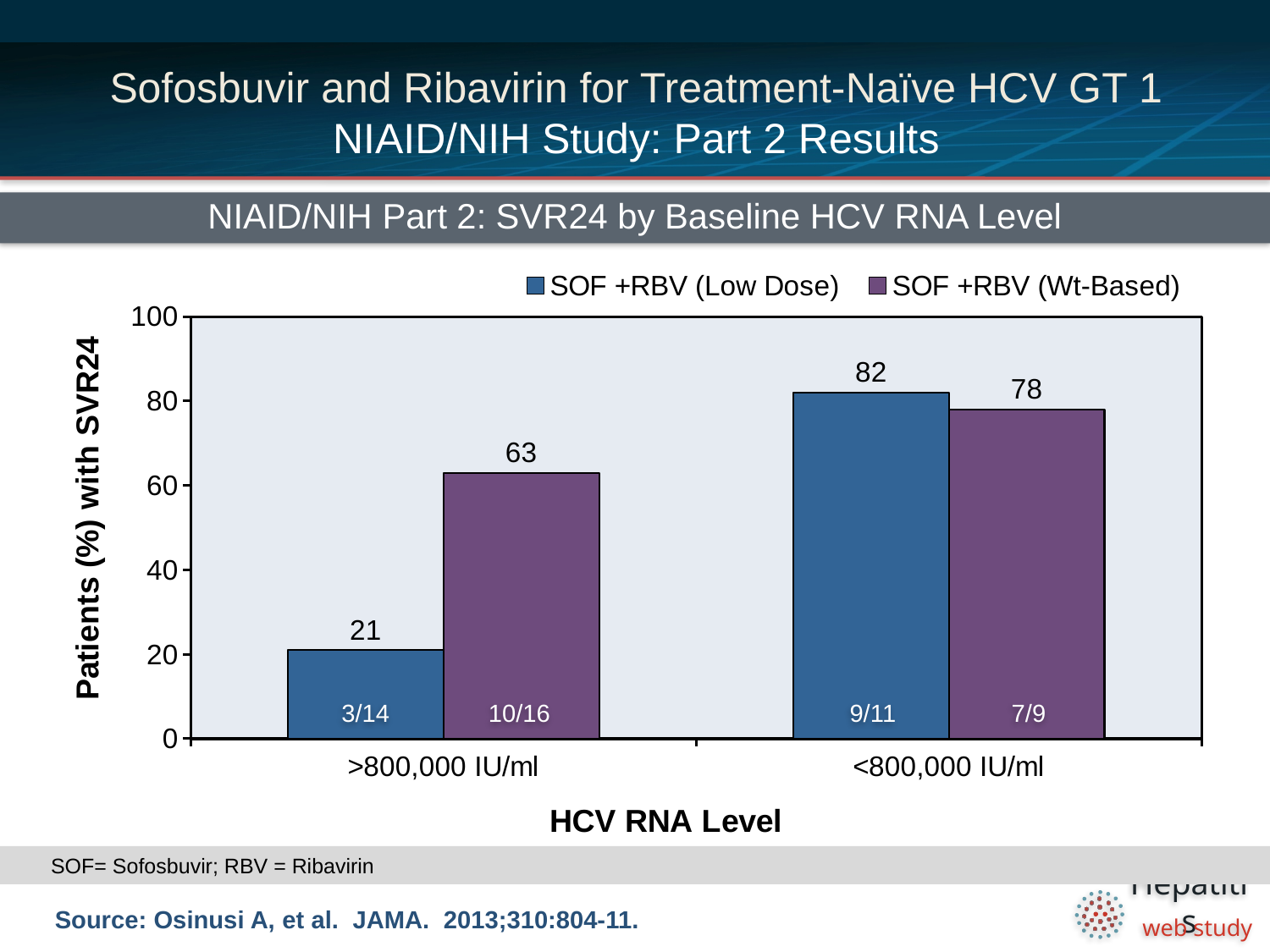
What is the SVR24 rate for SOF +RBV (Low Dose) in the >800,000 IU/ml group? 21 What is the SVR24 rate for SOF +RBV (Low Dose) in the <800,000 IU/ml group? 82 What is the SVR24 rate for SOF +RBV (Wt-Based) in the <800,000 IU/ml group? 78 How many series does the legend list? 2 What is the difference in SVR24 rate between SOF +RBV (Wt-Based) and SOF +RBV (Low Dose) in the >800,000 IU/ml group? 42 How many HCV RNA level categories are shown on the x axis? 2 What fraction of patients is shown inside the SOF +RBV (Low Dose) bar for the >800,000 IU/ml group? 3/14 Which bar shows the lowest SVR24 rate? SOF +RBV (Low Dose), >800,000 IU/ml What is the SVR24 rate for SOF +RBV (Wt-Based) in the >800,000 IU/ml group? 63 Which bar shows the highest SVR24 rate? SOF +RBV (Low Dose), <800,000 IU/ml In the <800,000 IU/ml group, which regimen has the higher SVR24 rate? SOF +RBV (Low Dose) What type of chart is shown on the slide? Bar chart